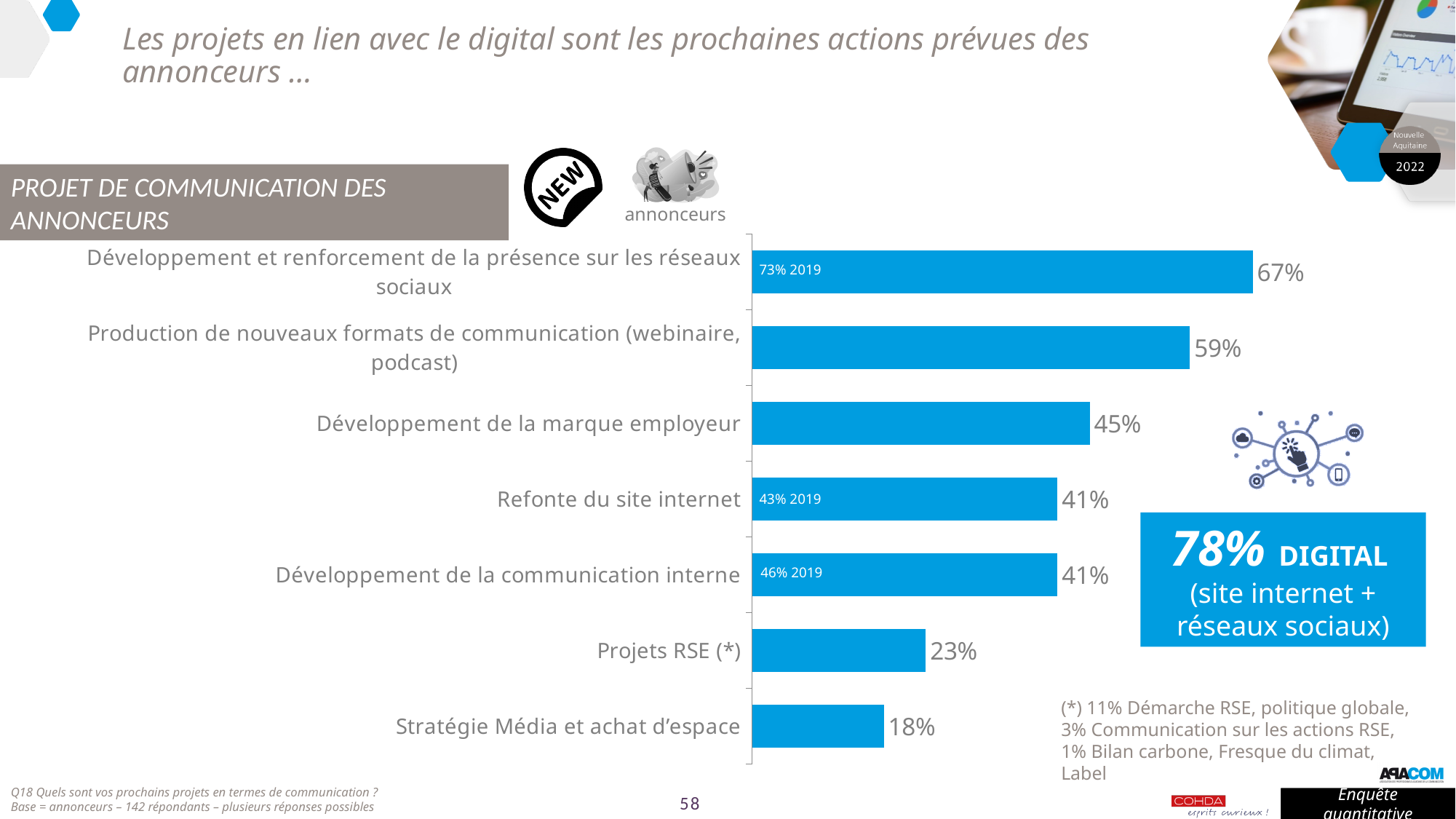
What is the value for "Développement et renforcement de la présence sur les réseaux sociaux"? 67% What is the value for "Développement de la marque employeur"? 45% What is the value for "Production de nouveaux formats de communication (webinaire, podcast)"? 59% What was the 2019 value shown for "Refonte du site internet"? 43% What was the 2019 value shown for "Développement de la communication interne"? 46% Which category has the lowest value? Stratégie Média et achat d'espace How many categories are shown in the chart? 7 What is the difference between the values for "Production de nouveaux formats de communication (webinaire, podcast)" and "Développement de la marque employeur"? 14% What is the value for "Projets RSE (*)"? 23% Which is larger: the value for "Projets RSE (*)" or the value for "Stratégie Média et achat d'espace"? Projets RSE (*) What kind of chart is shown on the slide? Bar chart Which category has the highest value? Développement et renforcement de la présence sur les réseaux sociaux